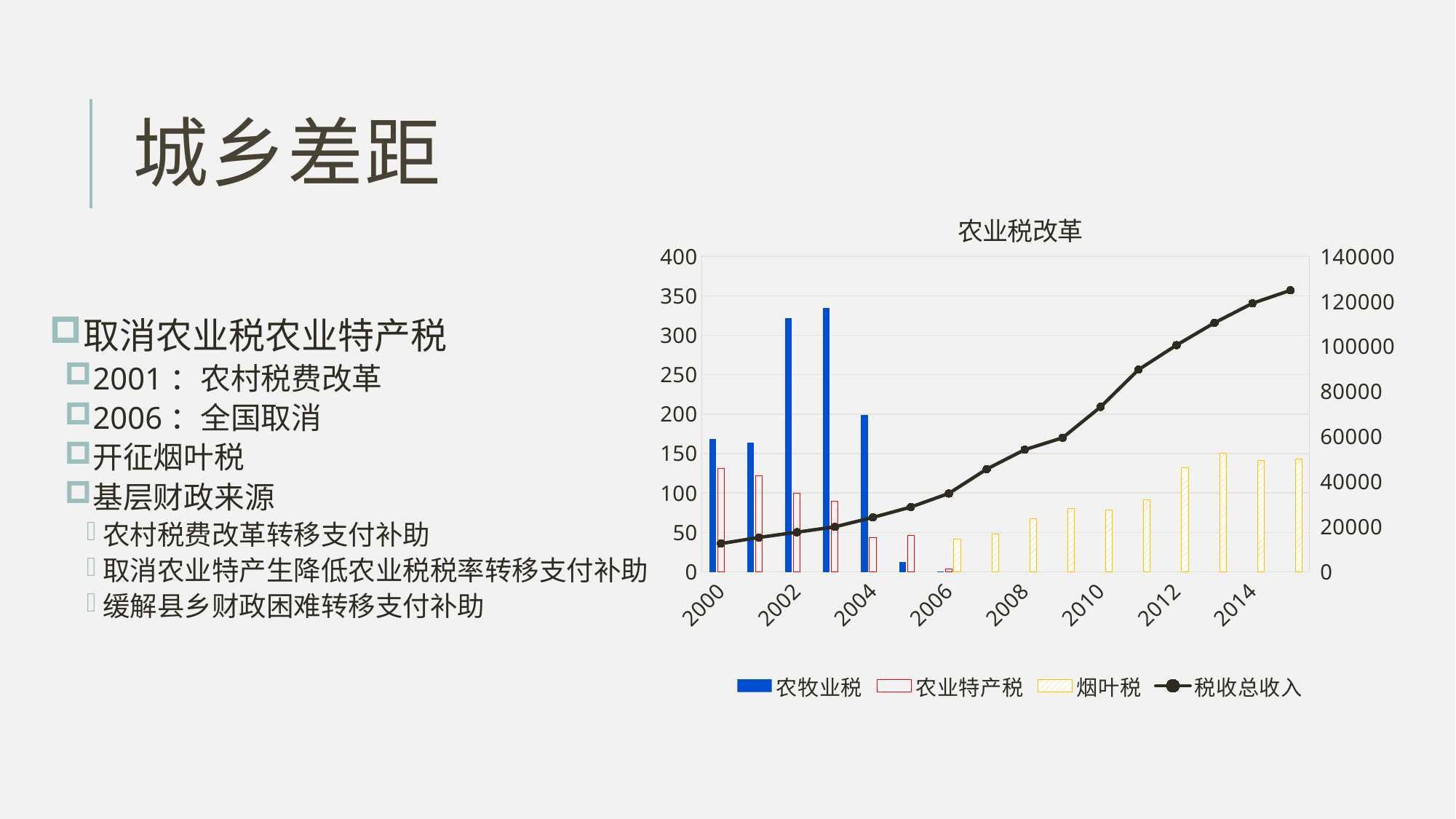
Is the 农牧业税 value for 2000 greater or less than 150? greater Which series is plotted as a line in the chart? 税收总收入 What is the title of the chart? 农业税改革 Which is larger, the 农牧业税 value for 2002 or for 2000? 2002 How many years are shown along the x axis of the chart? 16 Is the 税收总收入 value for 2006 greater or less than 40000? less Is the 税收总收入 value for 2015 greater or less than 120000? greater Which is larger, the 烟叶税 value for 2013 or for 2008? 2013 Does the 税收总收入 line rise or fall from 2000 to 2015? Rises What kind of chart is shown on the slide? A combined bar and line chart How many series does the chart legend list? 4